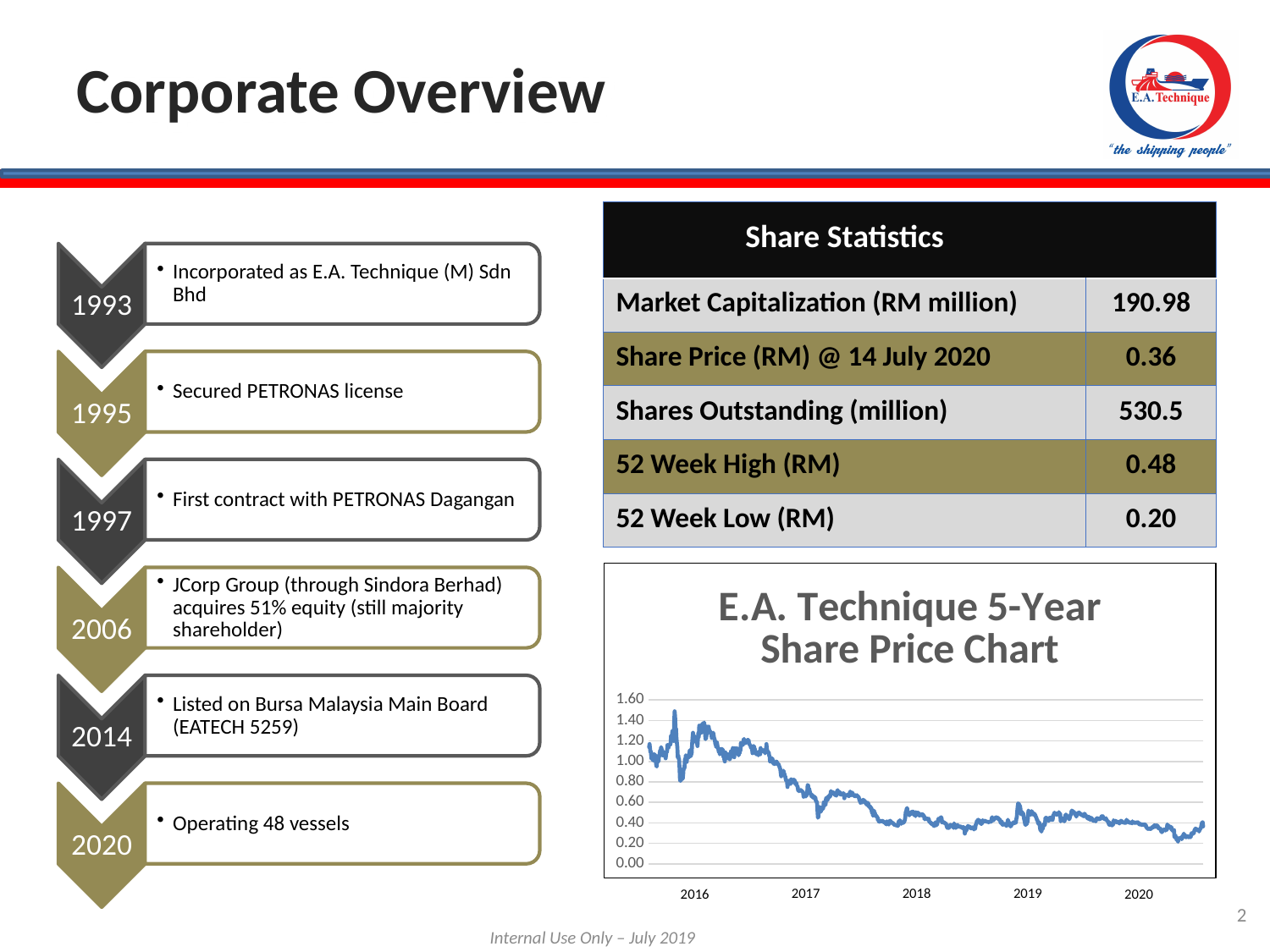
How many year labels are shown on the x axis of the E.A. Technique 5-Year Share Price Chart? 5 What is the highest value shown on the y axis of the E.A. Technique 5-Year Share Price Chart? 1.60 In the E.A. Technique 5-Year Share Price Chart, which year shows a higher share price, 2017 or 2019? 2017 Overall, does the share price in the E.A. Technique 5-Year Share Price Chart rise or fall from 2016 to 2020? fall In the E.A. Technique 5-Year Share Price Chart, is the share price around 2016 greater or less than 0.80? greater In the E.A. Technique 5-Year Share Price Chart, is the share price around 2019 greater or less than 1.00? less In the E.A. Technique 5-Year Share Price Chart, in which labelled year does the share price reach its highest level? 2016 In the E.A. Technique 5-Year Share Price Chart, which year shows a higher share price, 2016 or 2020? 2016 In the E.A. Technique 5-Year Share Price Chart, is the share price around 2020 greater or less than 0.60? less What is the title of the chart on the slide? E.A. Technique 5-Year Share Price Chart What kind of chart is the E.A. Technique 5-Year Share Price Chart? line chart